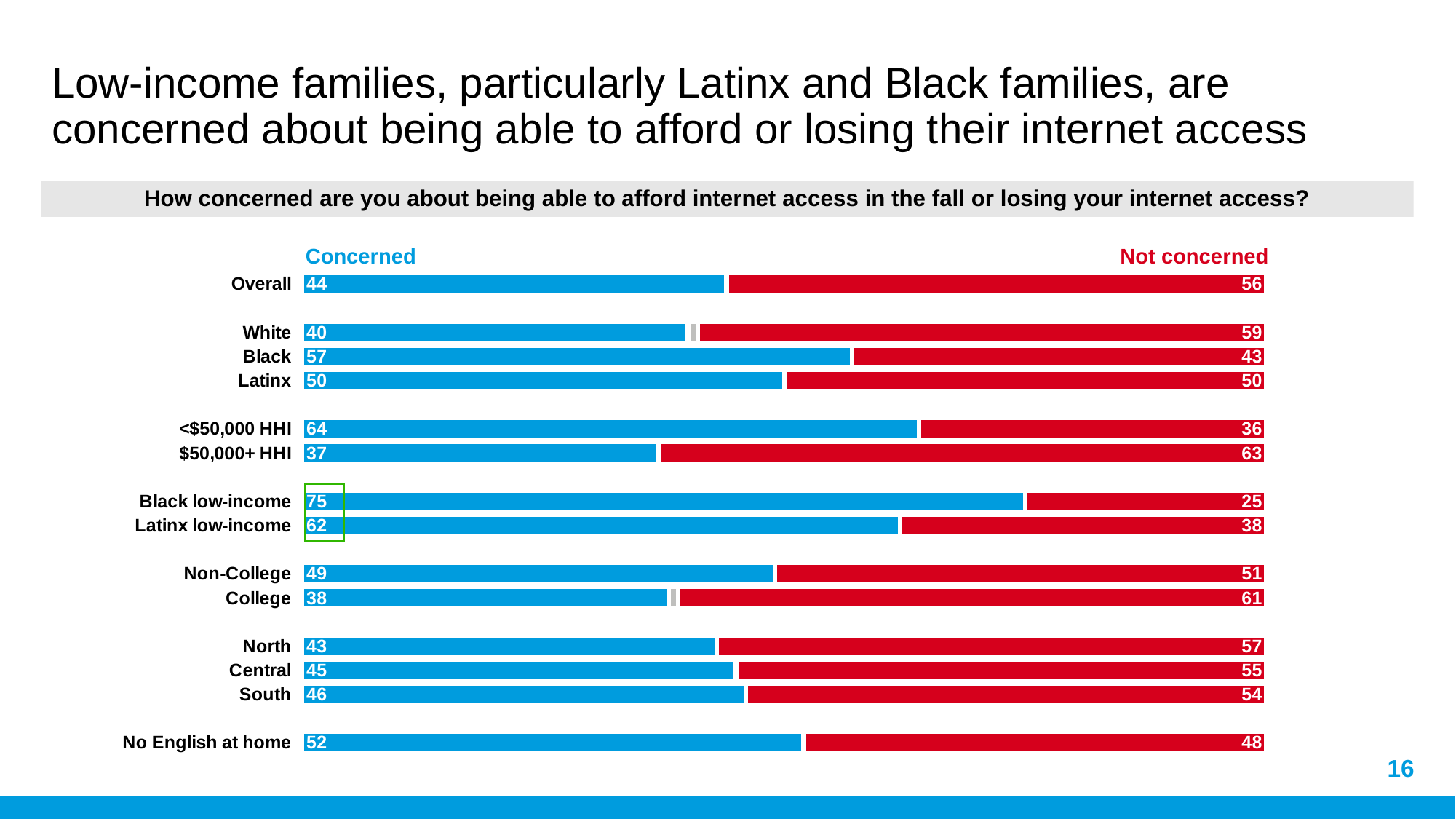
Which category has the lowest Concerned value? $50,000+ HHI Which category has the highest Concerned value? Black low-income What is the total of the Concerned and Not concerned values for No English at home? 100 How many series does the chart show? 2 Which has a larger Concerned value, Black or White? Black What kind of chart is shown on the slide? Stacked bar chart What colour represents the Not concerned series? Red What is the Concerned value for Overall? 44 What is the difference between the Concerned values for Black low-income and Latinx low-income? 13 What is the Not concerned value for Black low-income? 25 How many categories are shown in the chart? 14 What is the Concerned value for <$50,000 HHI? 64